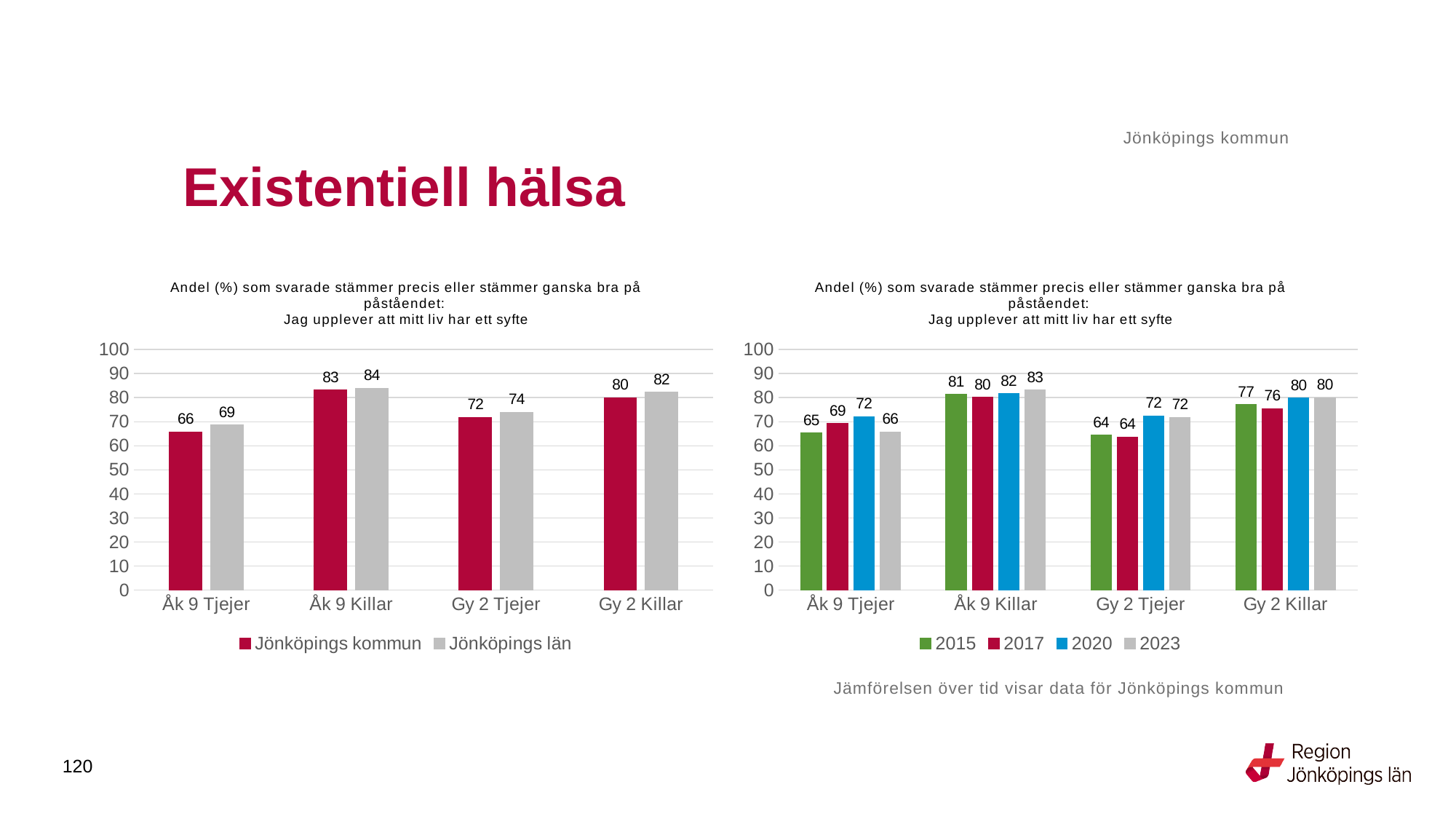
In the right chart, what is the value for 2020 for Gy 2 Tjejer? 72 In the right chart, which is larger for Åk 9 Tjejer: the value for 2020 or the value for 2023? 2020 In the right chart, how many series does the legend list? 4 In the left chart, what is the value for Jönköpings kommun for Åk 9 Tjejer? 66 In the right chart, what is the difference between the 2015 and 2023 values for Gy 2 Tjejer? 8 In the left chart, what is the difference between Jönköpings län and Jönköpings kommun for Åk 9 Tjejer? 3 In the left chart, how many series does the legend list? 2 In the left chart, which category has the highest value for Jönköpings kommun? Åk 9 Killar What kind of chart is the right chart? Bar chart In the right chart, what is the value for 2023 for Åk 9 Killar? 83 In the left chart, what is the value for Jönköpings län for Gy 2 Killar? 82 In the left chart, which category has the lowest value for Jönköpings län? Åk 9 Tjejer